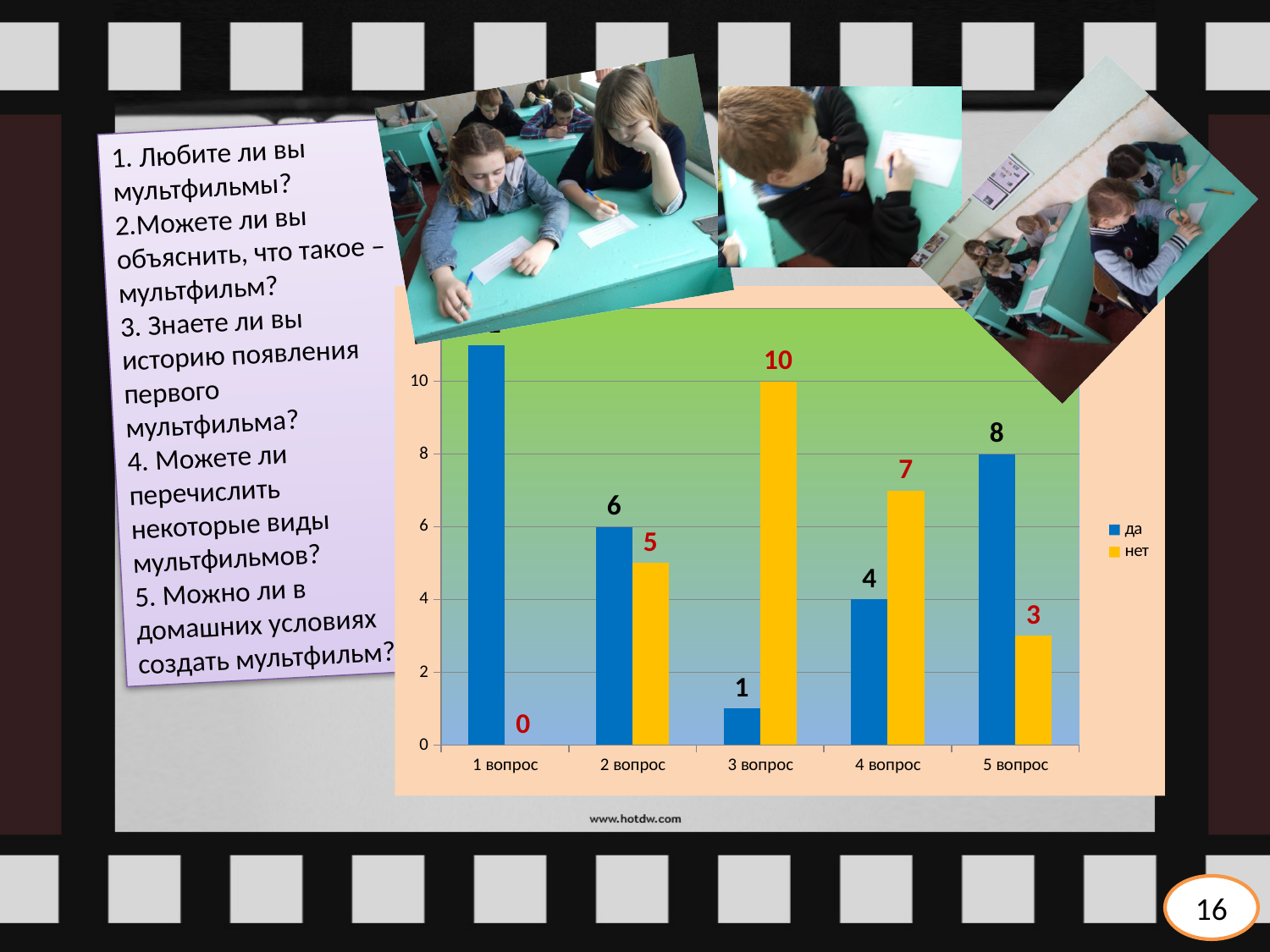
What is the difference between "нет" and "да" for "3 вопрос"? 9 Which category has the highest value for "нет"? 3 вопрос Is the value of "да" for "1 вопрос" greater or less than 10? greater Which category has the highest value for "да"? 1 вопрос What kind of chart is shown on the slide? bar chart What is the value of "нет" for "3 вопрос"? 10 Which category has the lowest value for "да"? 3 вопрос What is the value of "нет" for "1 вопрос"? 0 How many categories are shown on the x axis? 5 For "5 вопрос", which is larger, "да" or "нет"? да What is the value of "да" for "2 вопрос"? 6 How many series does the legend list? 2